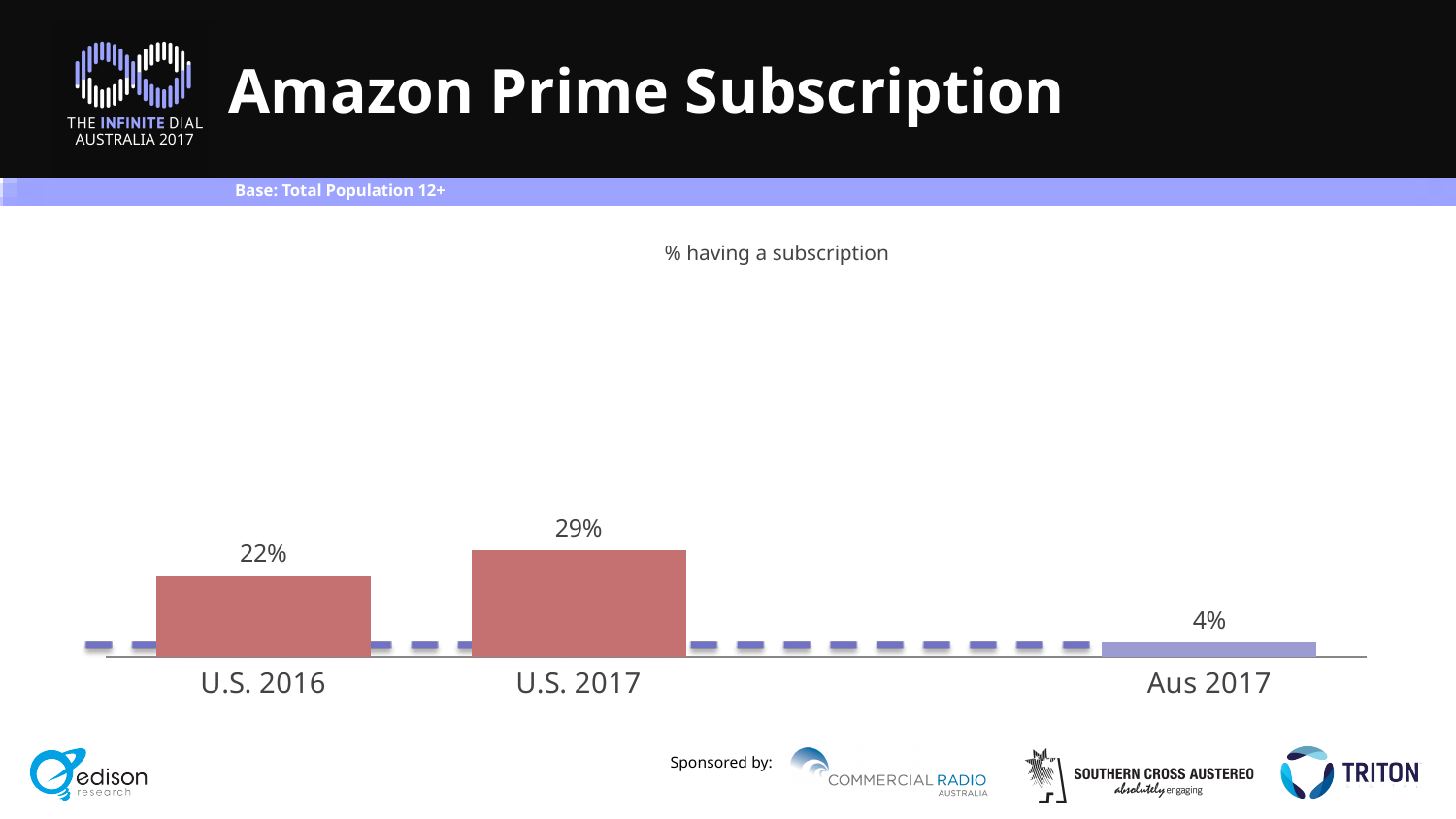
What is the difference between the values for U.S. 2017 and U.S. 2016? 7% How many categories are shown in the chart? 3 What is the value for U.S. 2017? 29% Which category has the highest value? U.S. 2017 What is the subtitle shown above the chart? % having a subscription What kind of chart is shown on the slide? Bar chart Which is larger, the value for U.S. 2016 or the value for Aus 2017? U.S. 2016 What is the value for Aus 2017? 4% What is the difference between the values for U.S. 2017 and Aus 2017? 25% Do the values rise or fall from U.S. 2016 to U.S. 2017? Rise Which category has the lowest value? Aus 2017 What is the value for U.S. 2016? 22%